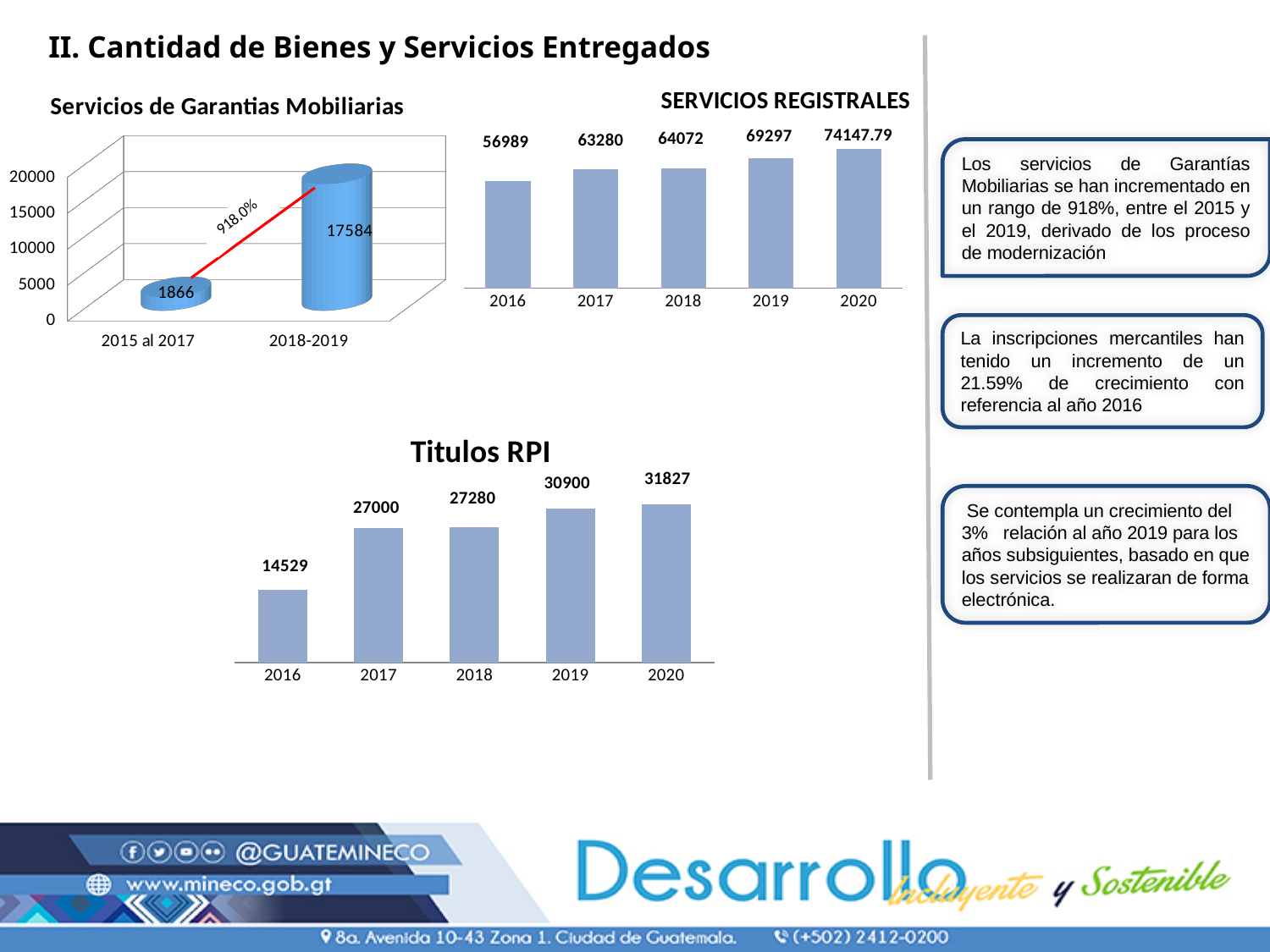
In the 'SERVICIOS REGISTRALES' chart, which year has the lowest value? 2016 In the 'Titulos RPI' chart, which year has the highest value? 2020 In the 'SERVICIOS REGISTRALES' chart, what is the difference between the 2019 and 2017 values? 6017 In the 'SERVICIOS REGISTRALES' chart, what is the value for 2020? 74147.79 In the 'Servicios de Garantias Mobiliarias' chart, what percentage is printed on the red line between the two bars? 918.0% In the 'Titulos RPI' chart, what is the value for 2016? 14529 In the 'Servicios de Garantias Mobiliarias' chart, which category is larger, '2015 al 2017' or '2018-2019'? 2018-2019 In the 'SERVICIOS REGISTRALES' chart, what is the value for 2018? 64072 In the 'Titulos RPI' chart, how many years are shown on the x axis? 5 In the 'Servicios de Garantias Mobiliarias' chart, what is the value for '2018-2019'? 17584 In the 'SERVICIOS REGISTRALES' chart, do the values rise or fall from 2016 to 2020? rise In the 'Titulos RPI' chart, what is the difference between the 2017 and 2016 values? 12471